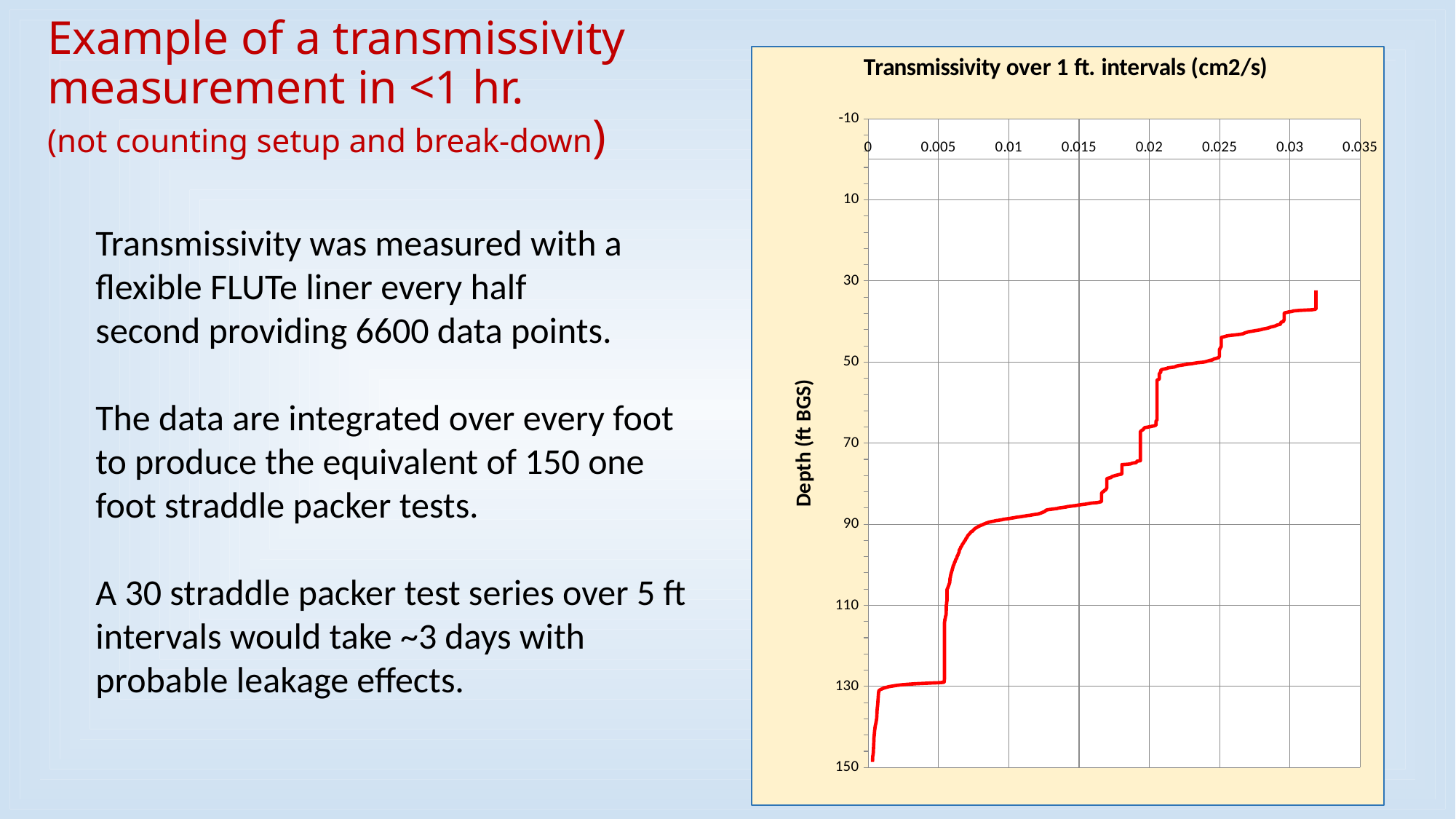
Is the transmissivity at a depth of 50 ft greater or less than 0.02? greater What is the maximum value shown on the horizontal (transmissivity) axis? 0.035 What is the title of the chart? Transmissivity over 1 ft. intervals (cm2/s) Which depth has the larger transmissivity, 50 ft or 130 ft? 50 ft Is the transmissivity at a depth of 140 ft greater or less than 0.005? less Is the transmissivity at a depth of 120 ft greater or less than 0.01? less What is the label of the vertical axis of the chart? Depth (ft BGS) What kind of chart is shown on the slide? line chart As depth increases from 30 ft to 150 ft, does the transmissivity generally rise or fall? fall